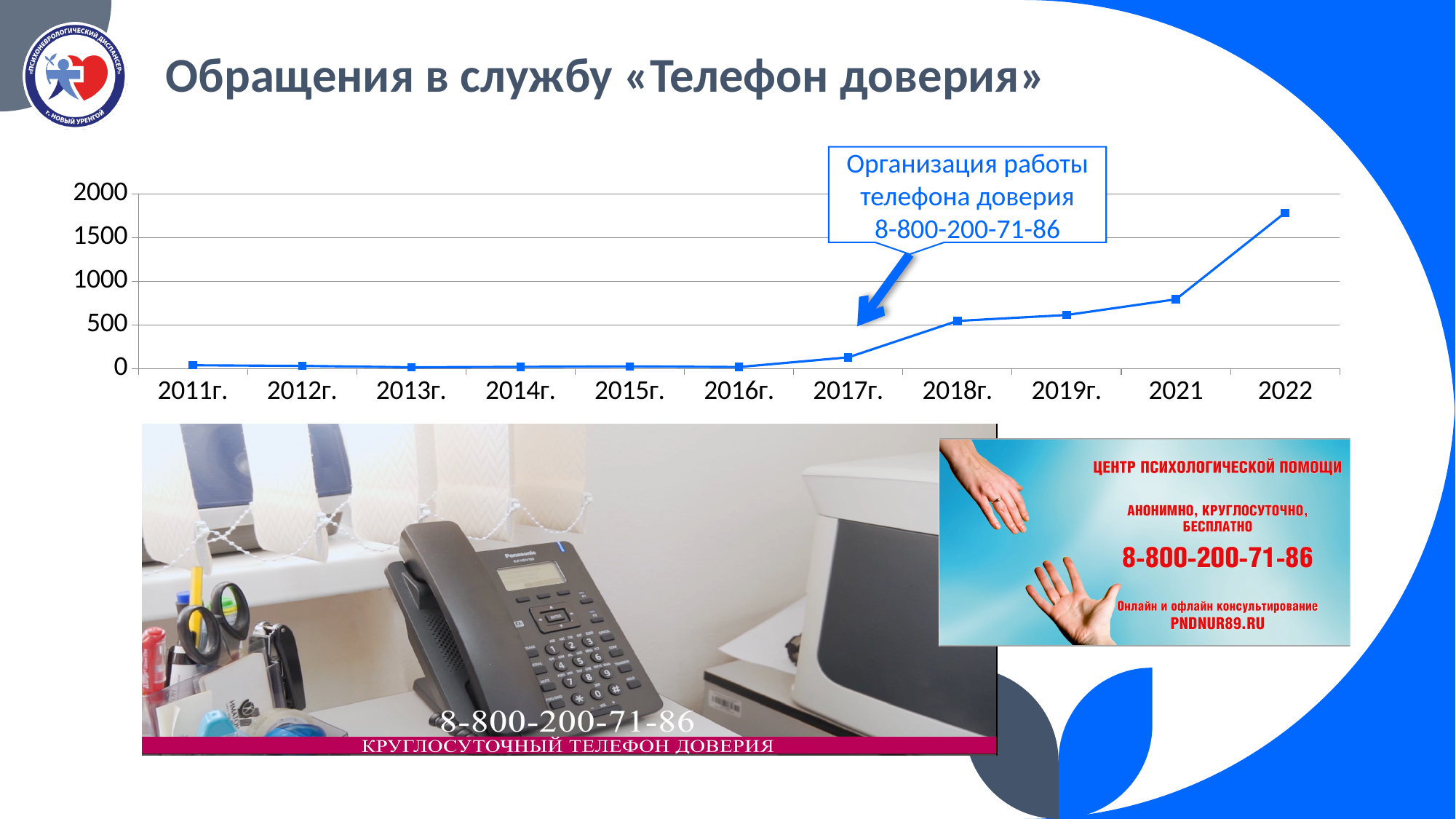
Which year has the highest value on the chart? 2022 Which is larger, the value for 2018г. or the value for 2016г.? 2018г. What kind of chart is shown on the slide? line chart Is the value for 2022 greater or less than 1500? greater How many data points are plotted on the chart? 11 What is the title of the chart on the slide? Обращения в службу «Телефон доверия» Is the value for 2017г. greater or less than 500? less Is the value for 2019г. greater or less than 1000? less Which is larger, the value for 2022 or the value for 2021? 2022 Do the values rise or fall from 2017г. to 2022? rise